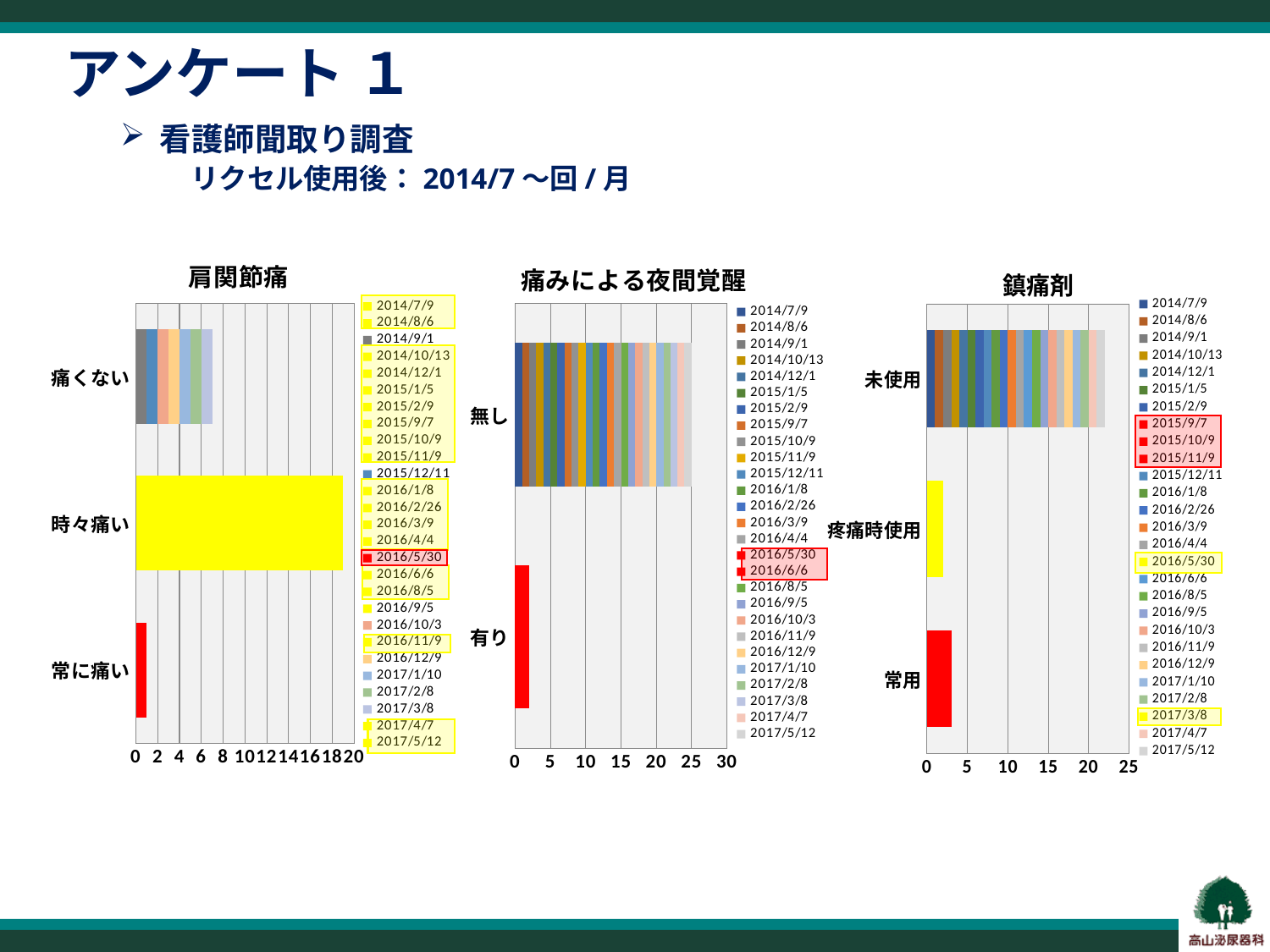
What kind of chart is the 肩関節痛 chart? bar chart In the 肩関節痛 chart, which category has the shortest bar? 常に痛い In the 肩関節痛 chart, which category has the longest bar? 時々痛い In the 鎮痛剤 chart, which category has the longest bar? 未使用 In the 肩関節痛 chart, is the total for 時々痛い greater or less than 10? greater How many series does the legend of the 鎮痛剤 chart list? 27 How many categories does the 肩関節痛 chart show on its vertical axis? 3 In the 痛みによる夜間覚醒 chart, which bar is longer, 無し or 有り? 無し How many categories does the 痛みによる夜間覚醒 chart show? 2 In the 鎮痛剤 chart, is the total for 常用 greater or less than 5? less What is the title of the middle chart on the slide? 痛みによる夜間覚醒 In the 痛みによる夜間覚醒 chart, is the total for 無し greater or less than 20? greater